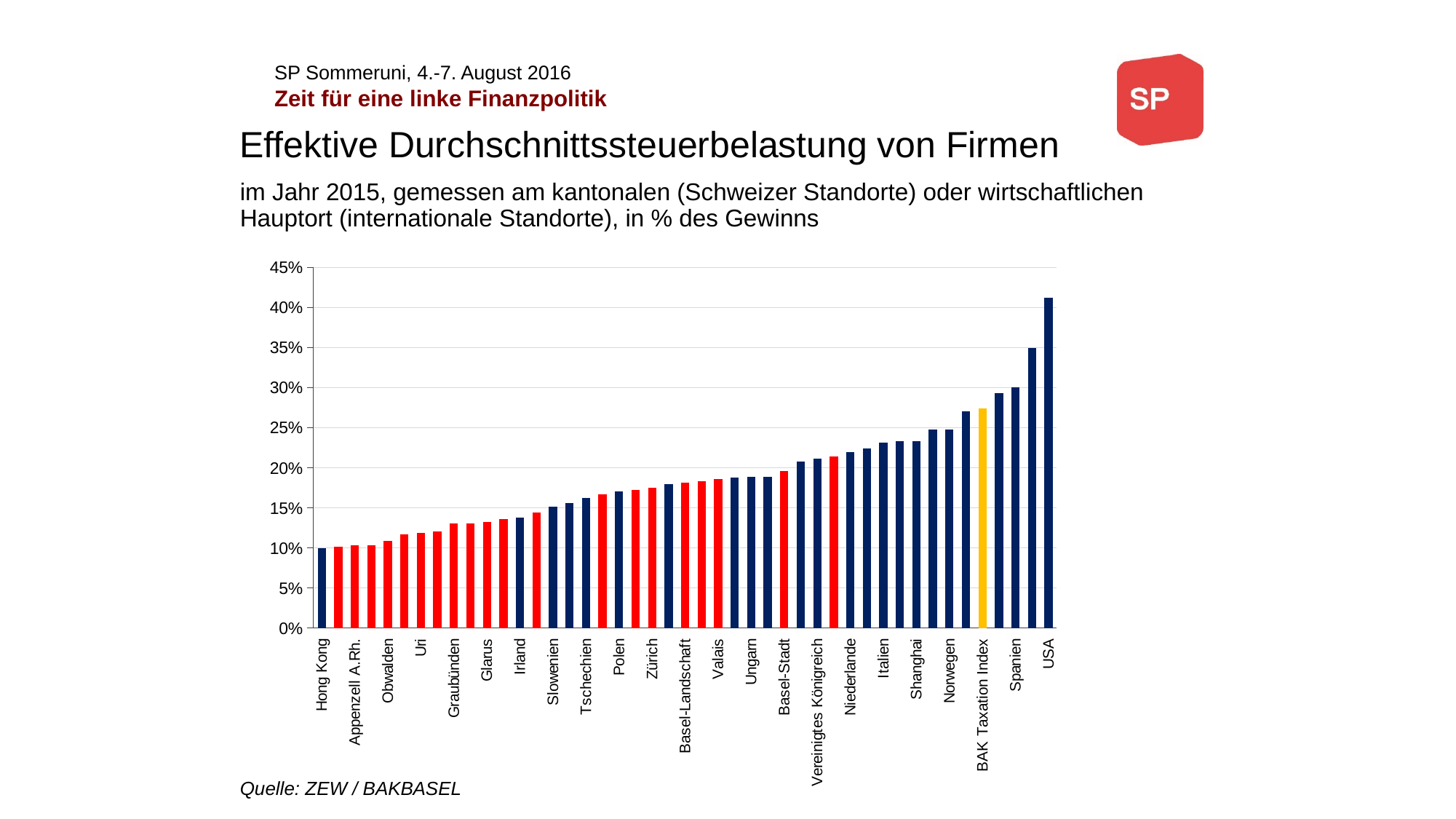
Is the value for USA greater or less than 40%? greater What kind of chart is shown on the slide? bar chart Is the value for Irland greater or less than 15%? less Is the value for Italien greater or less than 20%? greater Which has the larger value, Zürich or Basel-Stadt? Basel-Stadt What colour is the bar for BAK Taxation Index? yellow Which category has the highest effective average tax burden in the chart? USA Do the bar values rise or fall from left to right along the x axis? rise Which category has the lowest effective average tax burden in the chart? Hong Kong